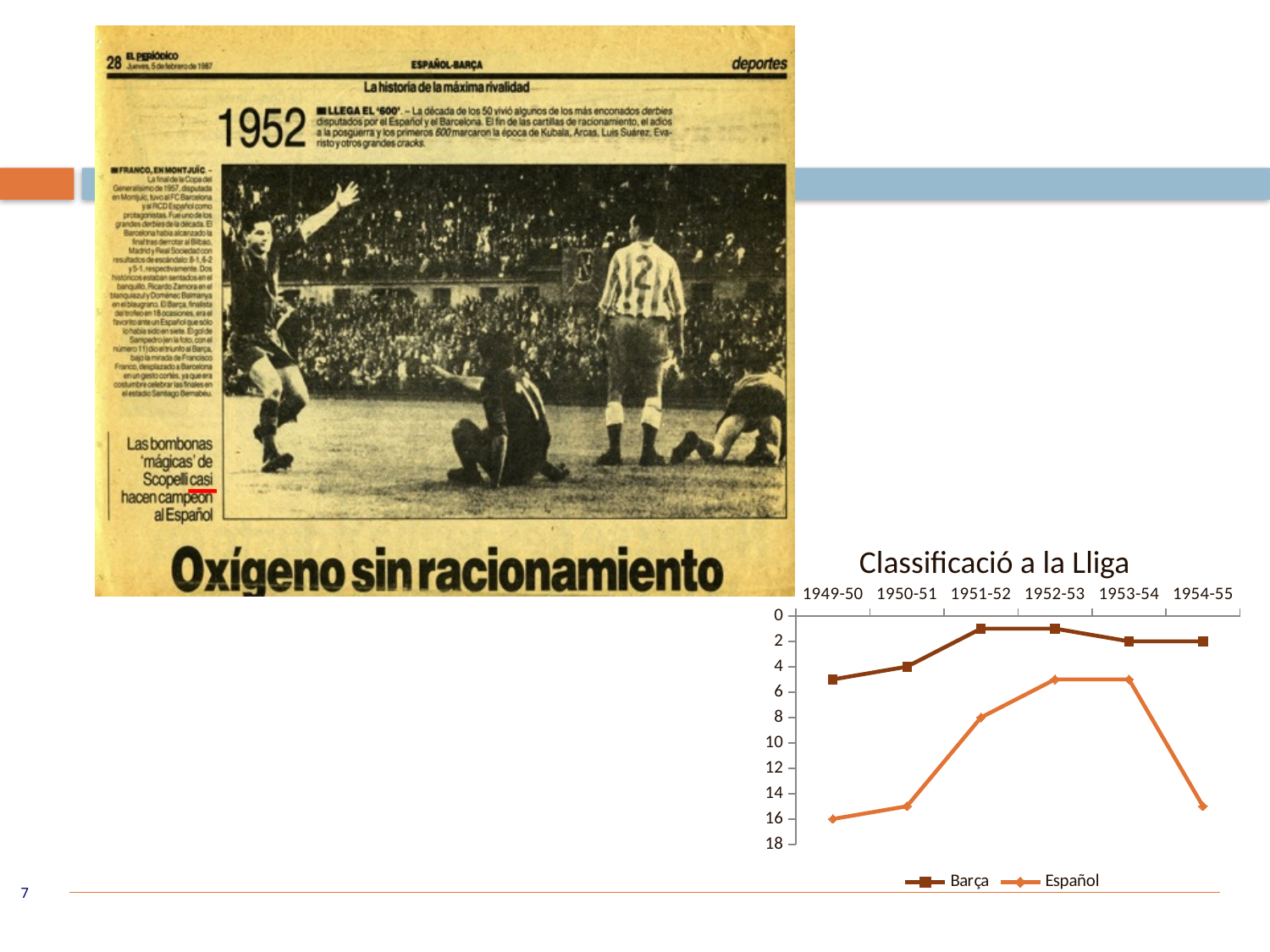
How many seasons are plotted along the x axis of the chart? 6 What is the difference between the Español value in 1949-50 and the Español value in 1951-52? 8 Which two series are listed in the chart legend? Barça and Español What is the value for Barça in 1950-51? 4 What is the value for Barça in 1953-54? 2 How many series does the chart legend list? 2 Is the value for Español in 1954-55 greater or less than 10? greater Which series has the larger value in 1949-50, Barça or Español? Español What is the value for Español in 1949-50? 16 What is the value for Español in 1951-52? 8 What is the title of the chart? Classificació a la Lliga What type of chart is shown on the slide? line chart